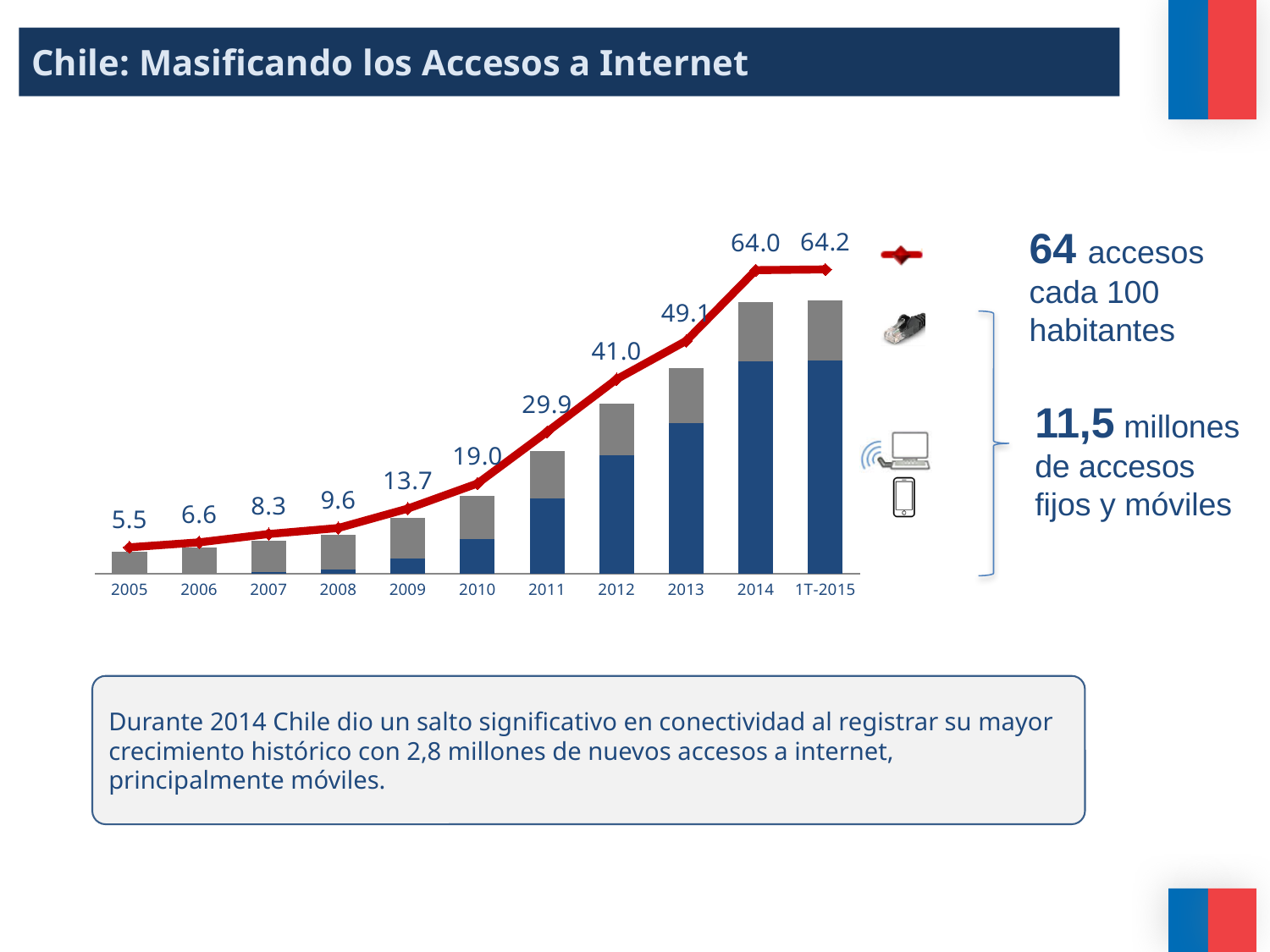
What value does the red line show for 1T-2015? 64.2 What kind of chart is shown on the slide? A combined stacked bar and line chart What value does the red line show for 2013? 49.1 What is the difference between the red line values for 2012 and 2011? 11.1 What value does the red line show for 2005? 5.5 How many categories are shown on the x axis? 11 Which category has the highest value on the red line? 1T-2015 Do the red line values rise or fall from 2005 to 1T-2015? rise What value does the red line show for 2010? 19.0 What is the difference between the red line values for 2014 and 2013? 14.9 Which year has the lowest value on the red line? 2005 Which is larger, the red line value for 2009 or for 2008? 2009